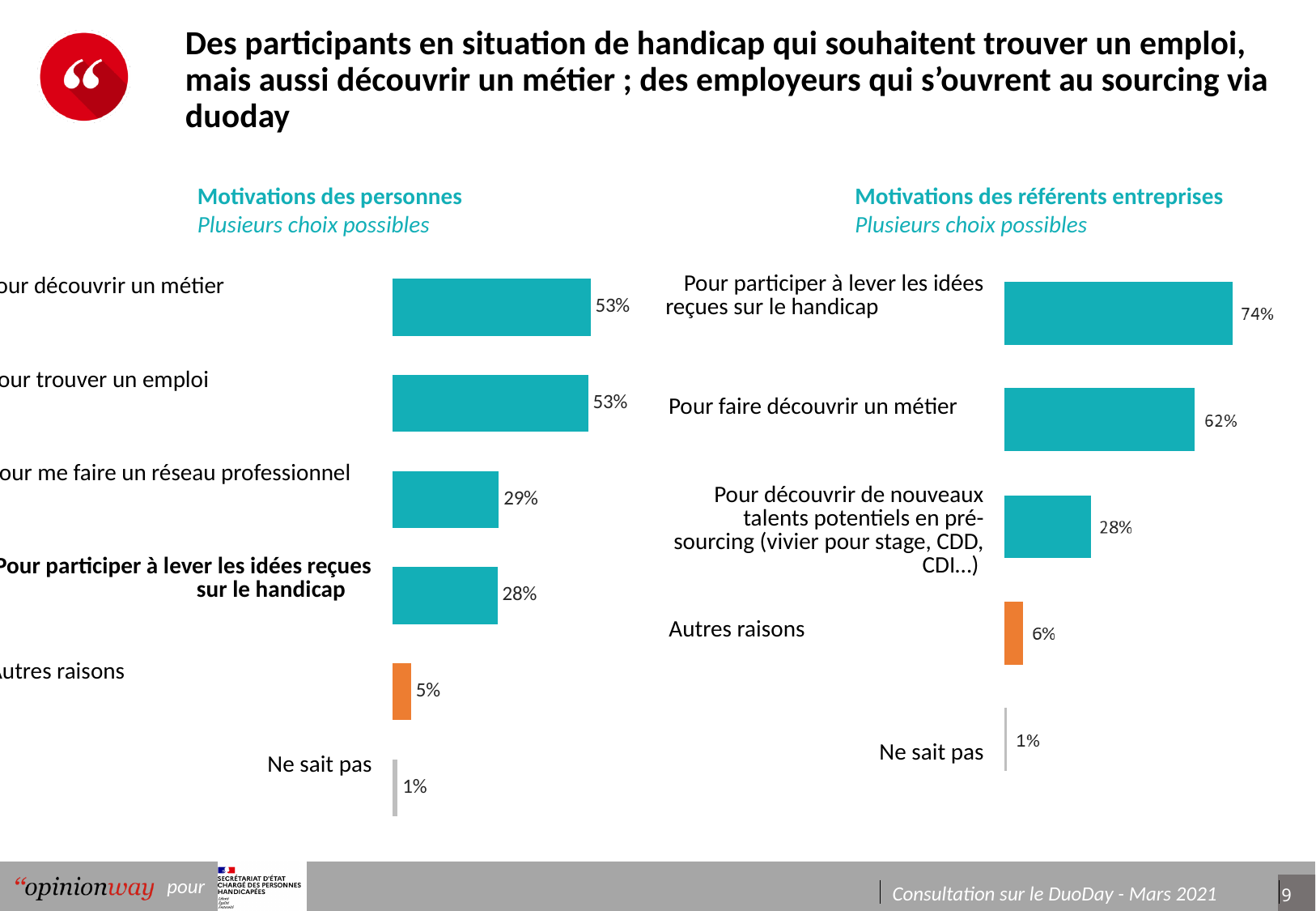
In the 'Motivations des référents entreprises' chart, which category has the highest value? Pour participer à lever les idées reçues sur le handicap In the 'Motivations des référents entreprises' chart, what is the value for 'Pour faire découvrir un métier'? 62% In the 'Motivations des référents entreprises' chart, what is the value for 'Pour participer à lever les idées reçues sur le handicap'? 74% In the 'Motivations des personnes' chart, what is the value for 'Pour me faire un réseau professionnel'? 29% In the 'Motivations des personnes' chart, which is larger: 'Pour me faire un réseau professionnel' or 'Autres raisons'? Pour me faire un réseau professionnel How many categories are shown in the 'Motivations des référents entreprises' chart? 5 In the 'Motivations des référents entreprises' chart, what is the difference between 'Pour participer à lever les idées reçues sur le handicap' and 'Pour faire découvrir un métier'? 12 percentage points In the 'Motivations des personnes' chart, what is the difference between 'Pour découvrir un métier' and 'Pour me faire un réseau professionnel'? 24 percentage points In the 'Motivations des personnes' chart, what is the value for 'Autres raisons'? 5% How many categories are shown in the 'Motivations des personnes' chart? 6 In the 'Motivations des personnes' chart, which category has the lowest value? Ne sait pas What type of chart is the 'Motivations des personnes' chart? Bar chart